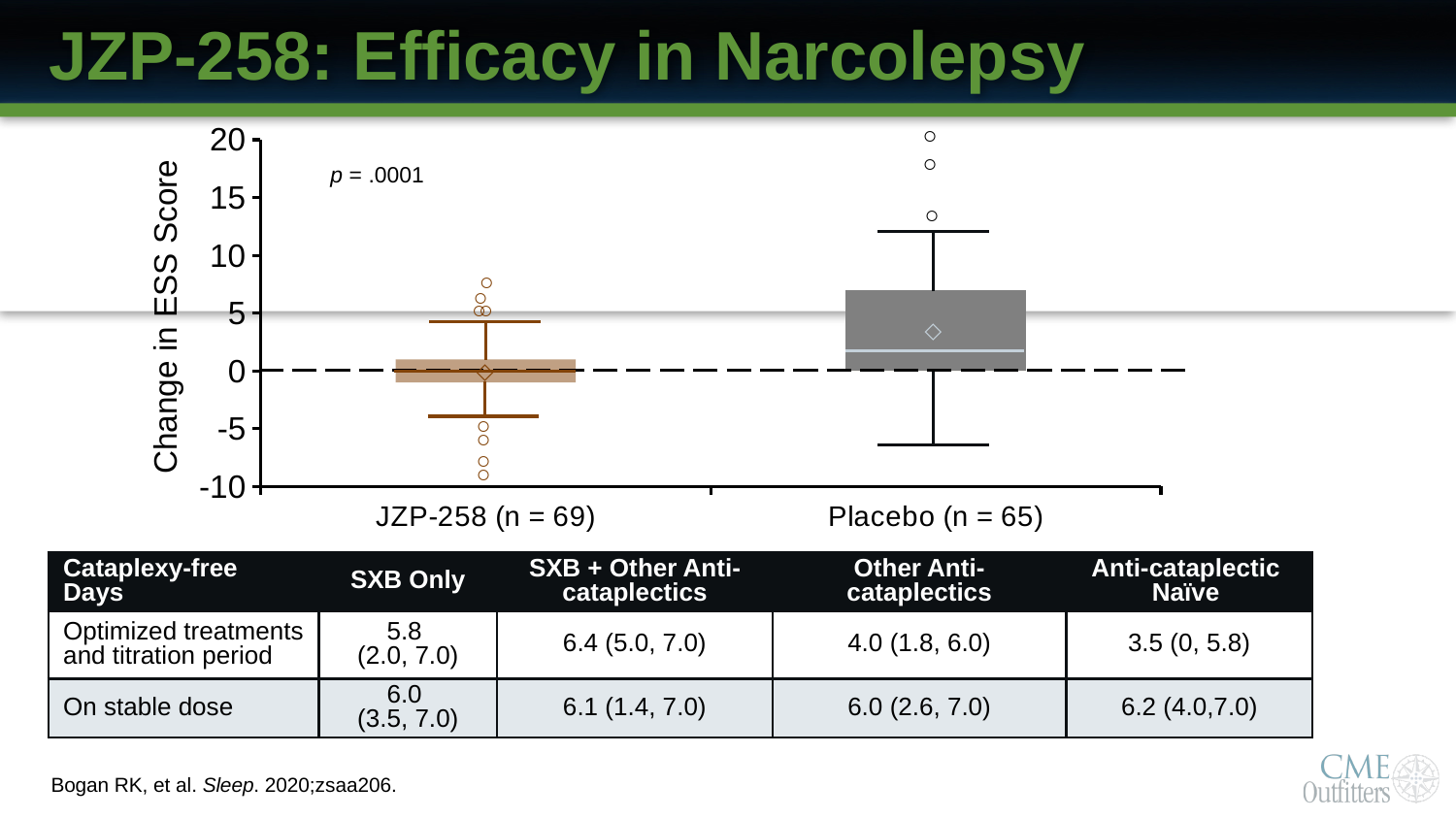
Is the highest outlier point for the Placebo group greater or less than 15? greater What is the sample size shown for the JZP-258 group? n = 69 What p-value is printed on the chart? p = .0001 Which group has the higher median change in ESS score, JZP-258 or Placebo? Placebo Is the top of the upper whisker for the Placebo group greater or less than 10? greater How many outlier points are plotted above the upper whisker for the Placebo group? 3 How many treatment groups are plotted on the x axis of the chart? 2 What is the label of the y axis of the chart? Change in ESS Score Is the top of the box for the Placebo group greater or less than 10? less What kind of chart is shown on the slide? Box plot What is the sample size shown for the Placebo group? n = 65